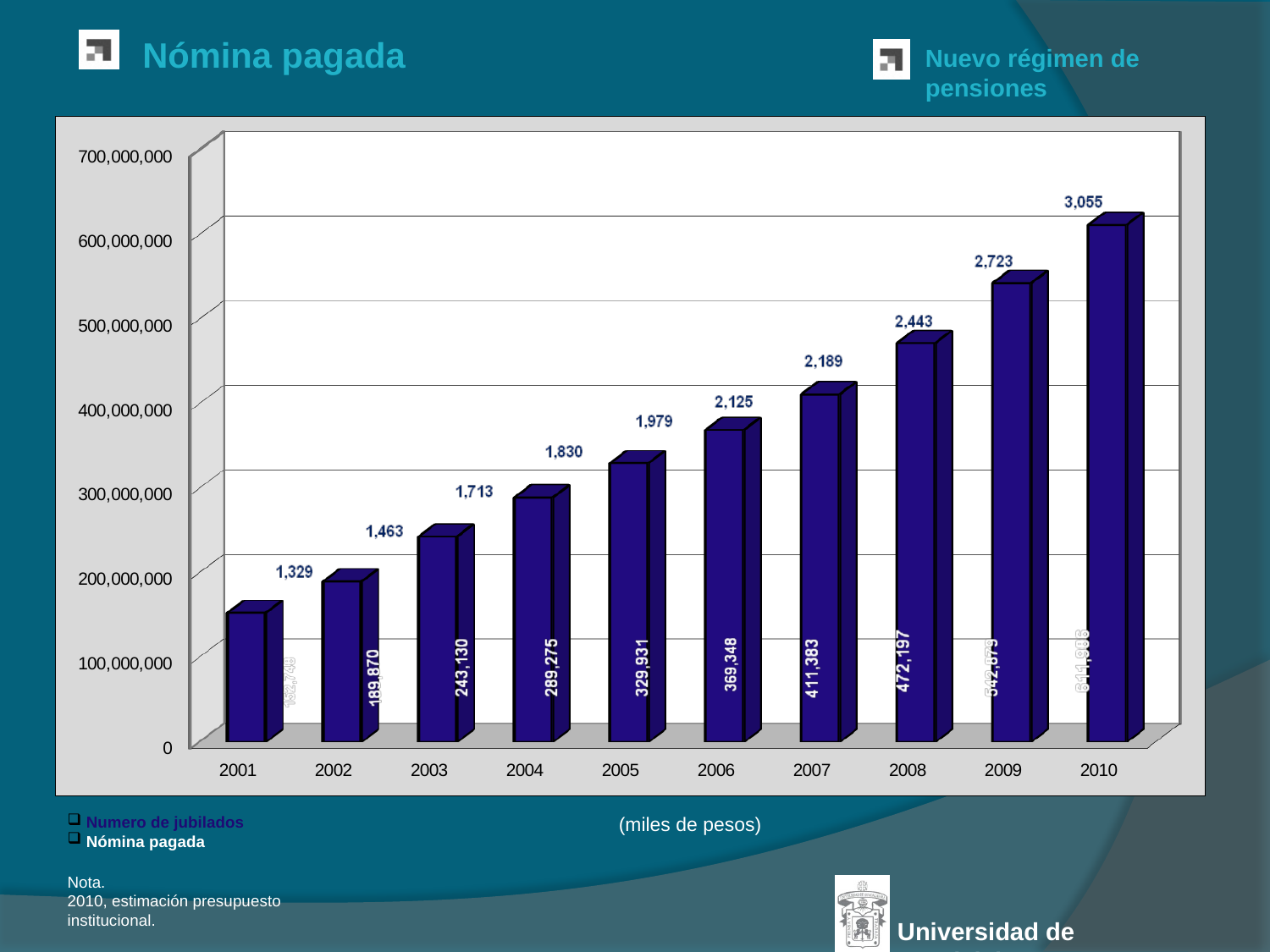
Which year has the larger Nómina pagada value, 2003 or 2004? 2004 What is the difference between the Nómina pagada values for 2008 and 2007? 60,814 What kind of chart is shown on the slide? bar chart Which year has the highest number of retirees? 2010 What is the Nómina pagada value printed on the bar for 2007? 411,383 What is the number of retirees (Numero de jubilados) shown above the bar for 2005? 1,979 What is the difference between the number of retirees in 2010 and in 2009? 332 Which year has the lowest Nómina pagada bar? 2001 Do the Nómina pagada values rise or fall from 2001 to 2010? rise How many years are shown on the x axis of the chart? 10 Is the bar for 2010 greater or less than 500,000,000 on the vertical axis? greater What is the number of retirees shown for 2008? 2,443